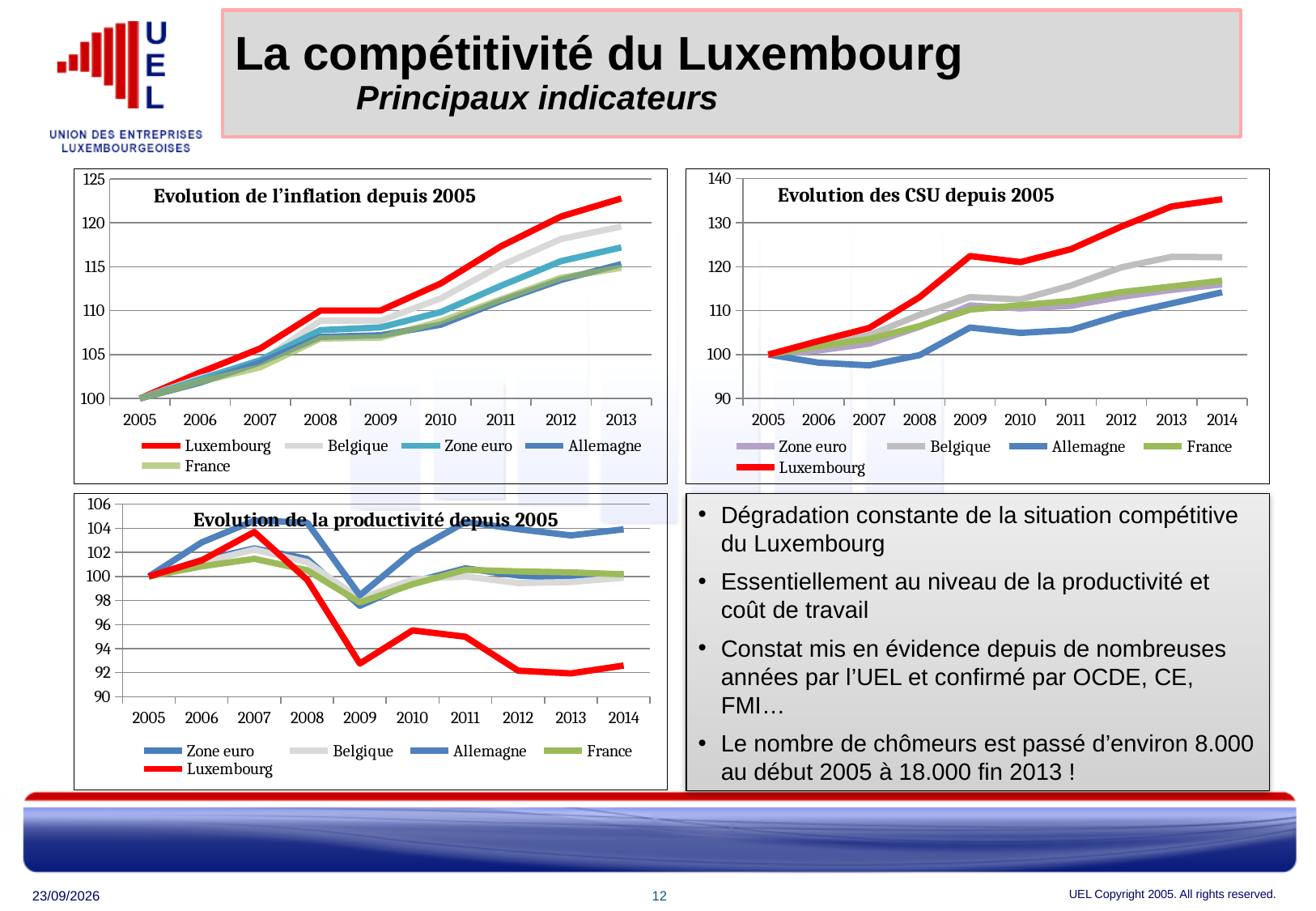
In the chart "Evolution de l'inflation depuis 2005", do the values for Luxembourg rise or fall from 2005 to 2013? rise In the chart "Evolution des CSU depuis 2005", which series has the lowest value in 2014? Allemagne In the chart "Evolution des CSU depuis 2005", is the value for Luxembourg in 2014 greater or less than 130? greater In the chart "Evolution de l'inflation depuis 2005", how many series does the legend list? 5 What kind of chart is "Evolution de l'inflation depuis 2005"? Line chart In the chart "Evolution des CSU depuis 2005", is the value for Allemagne in 2007 greater or less than 100? less In the chart "Evolution de l'inflation depuis 2005", how many years are shown on the x axis? 9 In the chart "Evolution de la productivité depuis 2005", is the value for Luxembourg in 2012 greater or less than 94? less In the chart "Evolution de la productivité depuis 2005", which is larger in 2014: Zone euro or Luxembourg? Zone euro In the chart "Evolution de la productivité depuis 2005", which series has the lowest value in 2014? Luxembourg In the chart "Evolution de l'inflation depuis 2005", which series has the highest value in 2013? Luxembourg